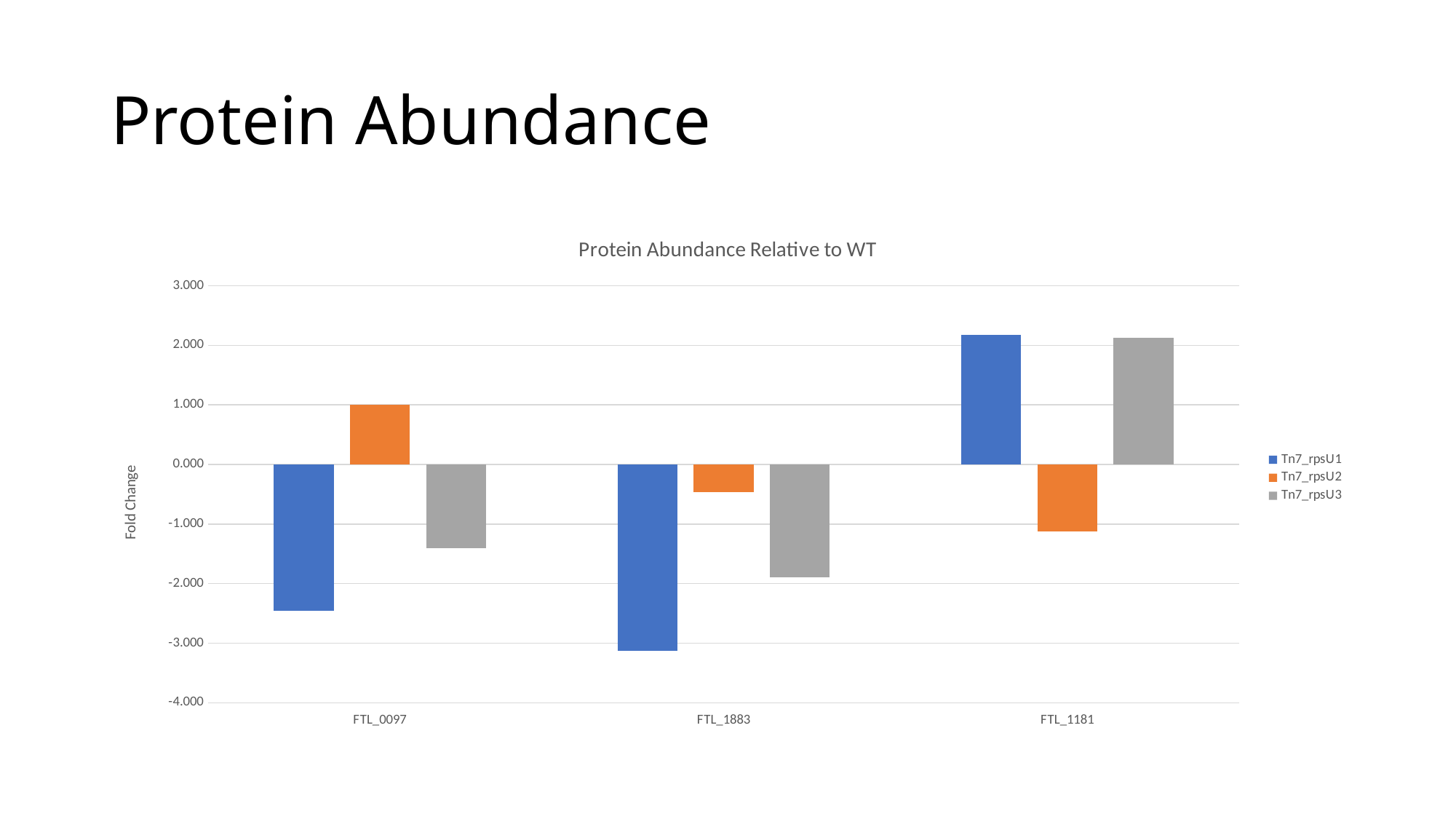
What is the title of the chart? Protein Abundance Relative to WT What is the label on the vertical axis of the chart? Fold Change What kind of chart is shown on the slide? bar chart Is the value for Tn7_rpsU2 at FTL_1883 greater or less than -1.000? greater Is the value for Tn7_rpsU1 at FTL_1883 greater or less than -3.000? less Is the value for Tn7_rpsU1 at FTL_0097 greater or less than -2.000? less Which is lower, the Tn7_rpsU1 value at FTL_0097 or the Tn7_rpsU1 value at FTL_1883? FTL_1883 How many series does the chart's legend list? 3 Which series has the lowest value at FTL_1883? Tn7_rpsU1 How many categories are shown on the x axis of the chart? 3